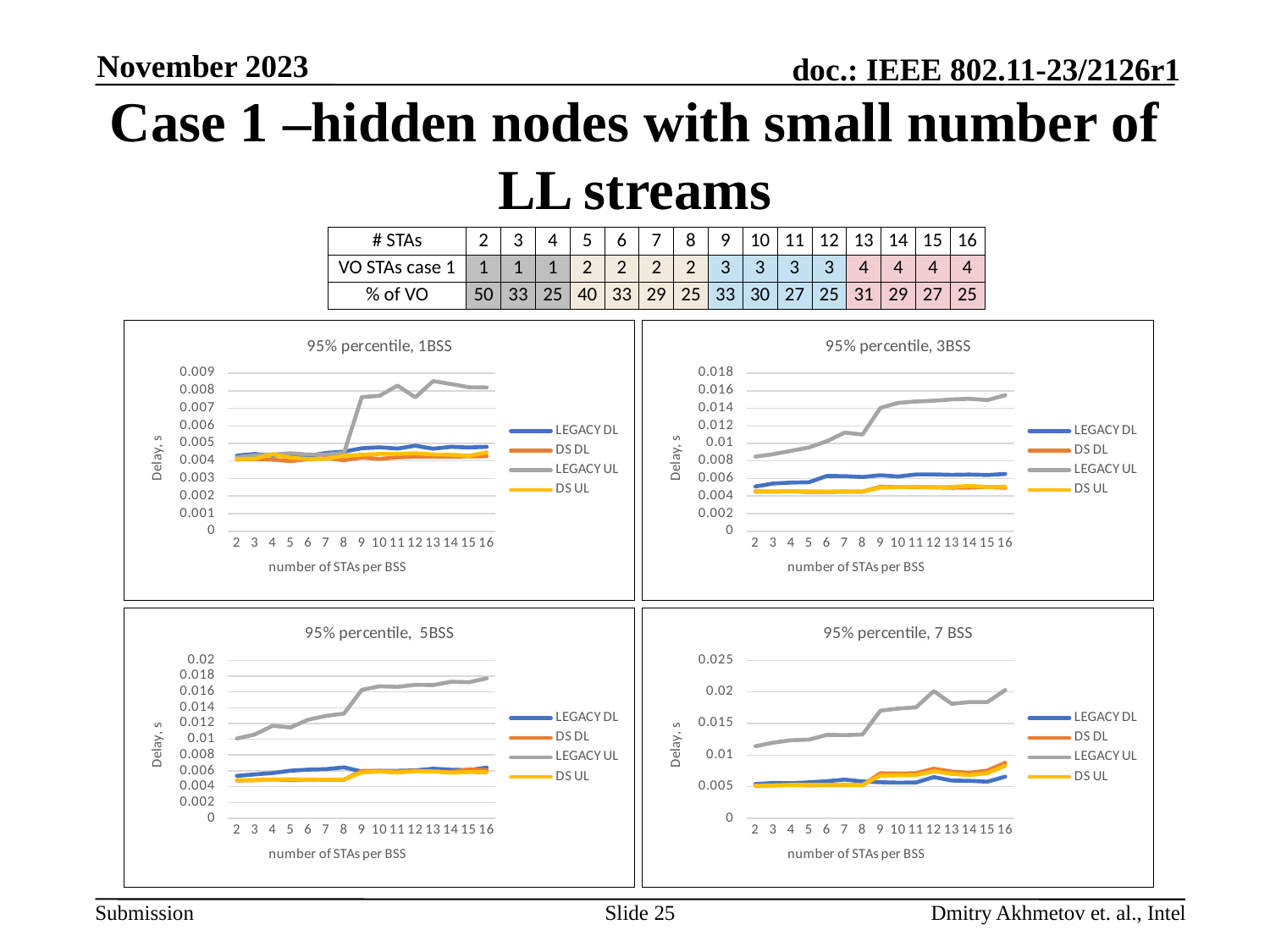
What kind of chart is the "95% percentile, 1BSS" chart? line chart In the "95% percentile, 7 BSS" chart, is the LEGACY DL value at 2 STAs greater or less than 0.01? less In the "95% percentile, 1BSS" chart, is the LEGACY UL value at 2 STAs greater or less than 0.006? less What is the x-axis label of the "95% percentile, 7 BSS" chart? number of STAs per BSS In the "95% percentile, 5BSS" chart, does the LEGACY UL series generally rise or fall as the number of STAs per BSS increases? rise How many x-axis points (number of STAs per BSS) are plotted in the "95% percentile, 5BSS" chart? 15 In the "95% percentile, 3BSS" chart, at 16 STAs, which is larger: LEGACY UL or DS UL? LEGACY UL How many series does the legend of the "95% percentile, 3BSS" chart list? 4 In the "95% percentile, 3BSS" chart, is the LEGACY UL value at 16 STAs greater or less than 0.012? greater What is the y-axis label of the "95% percentile, 5BSS" chart? Delay, s In the "95% percentile, 7 BSS" chart, which series has the highest values? LEGACY UL